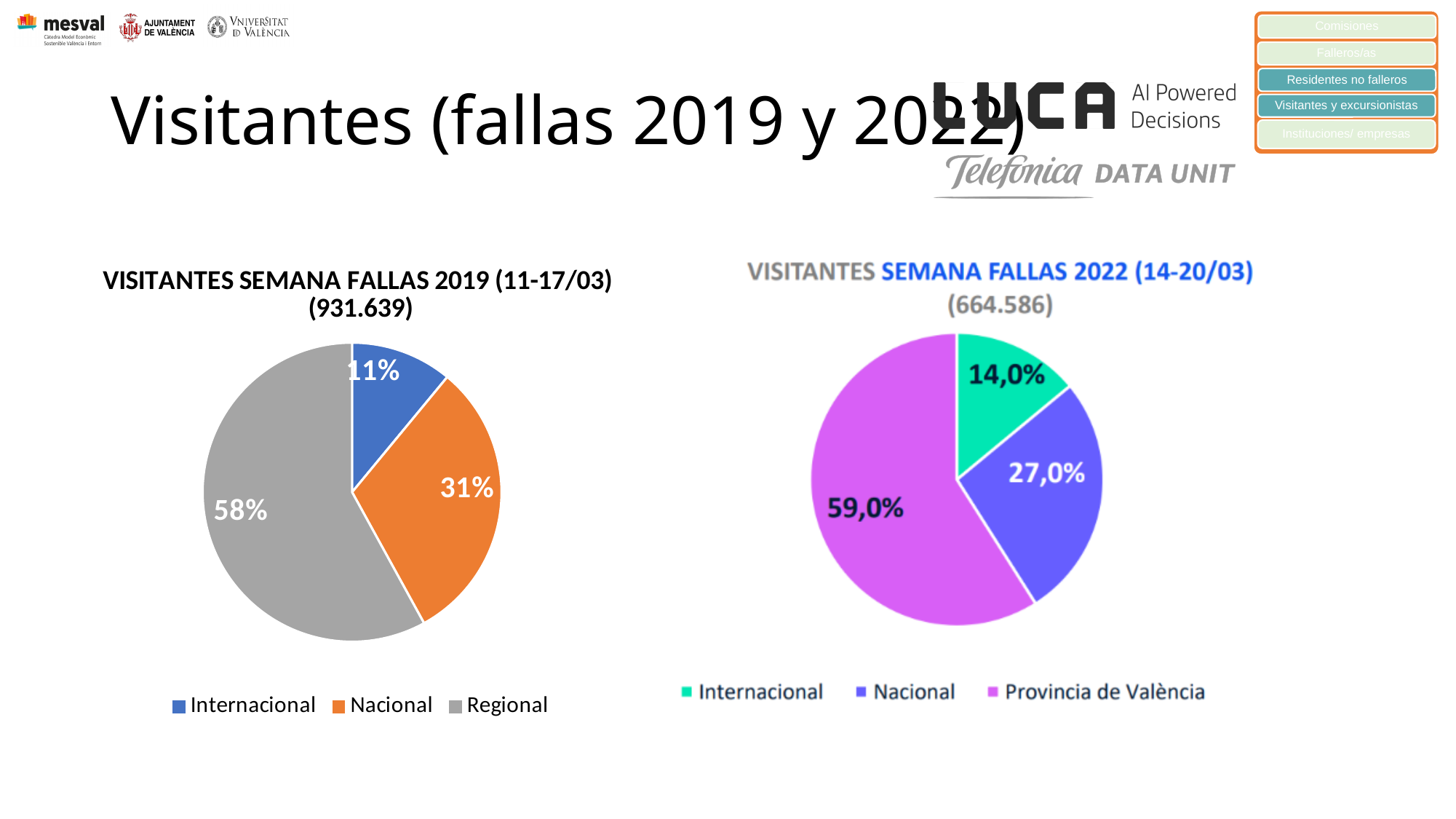
In the 2019 chart (VISITANTES SEMANA FALLAS 2019), what share of visitors is Nacional? 31% In the 2019 chart (VISITANTES SEMANA FALLAS 2019), what share of visitors is Internacional? 11% In the 2022 chart (VISITANTES SEMANA FALLAS 2022), what share of visitors is Internacional? 14,0% In the 2019 chart (VISITANTES SEMANA FALLAS 2019), what is the difference in percentage points between Regional and Nacional? 27 How many slices does the 2022 chart (VISITANTES SEMANA FALLAS 2022) have? 3 In the 2022 chart (VISITANTES SEMANA FALLAS 2022), which is larger, Nacional or Internacional? Nacional In the 2022 chart (VISITANTES SEMANA FALLAS 2022), what share of visitors is Provincia de València? 59,0% In the 2022 chart (VISITANTES SEMANA FALLAS 2022), which category has the largest slice? Provincia de València What kind of chart is the 2019 chart (VISITANTES SEMANA FALLAS 2019)? Pie chart In the 2019 chart (VISITANTES SEMANA FALLAS 2019), what share of visitors is Regional? 58% What total number of visitors is shown in the title of the 2022 chart (VISITANTES SEMANA FALLAS 2022)? 664.586 In the 2019 chart (VISITANTES SEMANA FALLAS 2019), which category has the smallest slice? Internacional